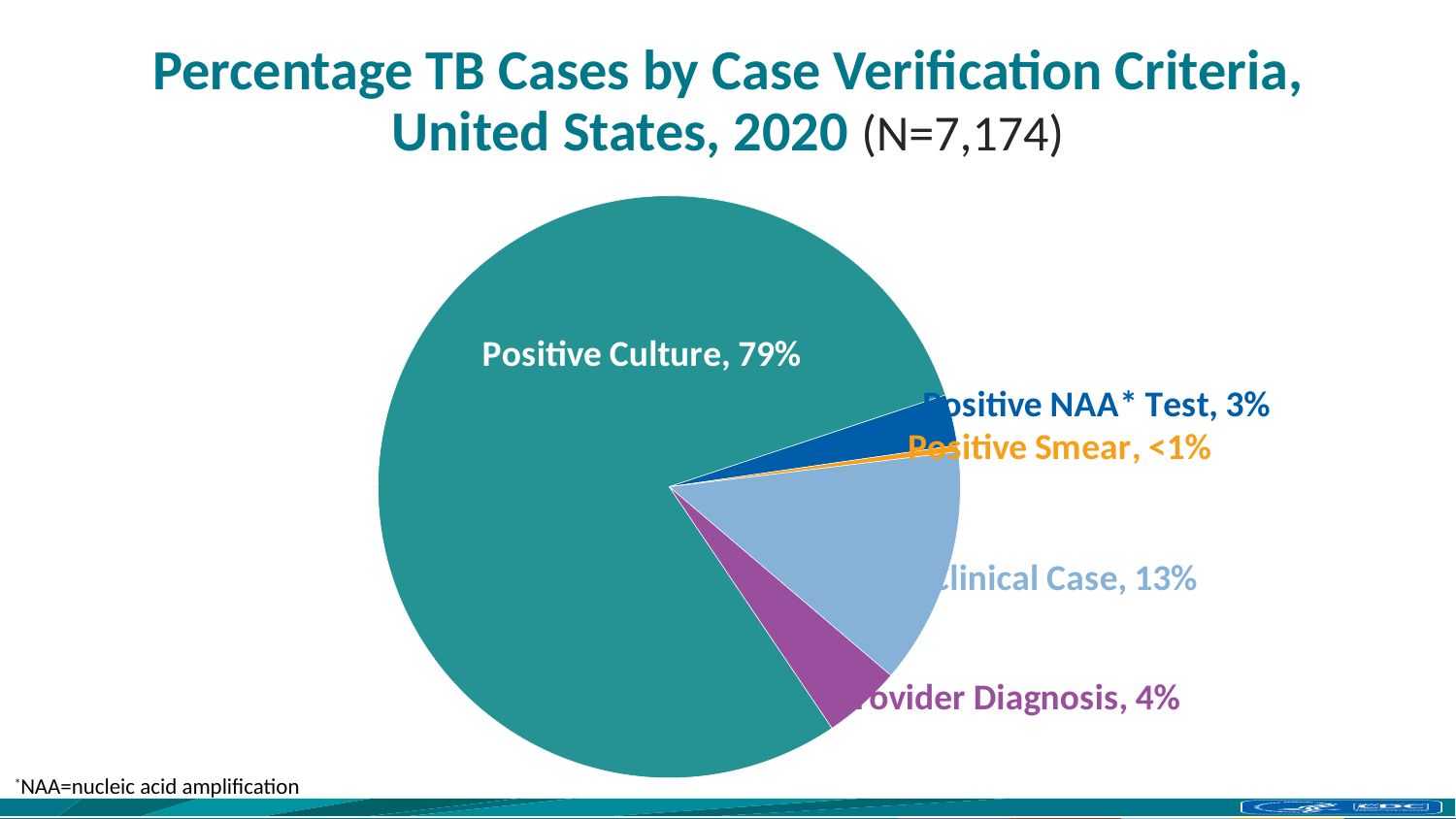
What is the total number of TB cases (N) stated in the chart title? 7,174 What kind of chart is shown on the slide? pie chart What percentage of TB cases were verified as Clinical Case? 13% What percentage of TB cases were verified by Positive NAA Test? 3% What is the difference in percentage points between Positive Culture and Clinical Case? 66 Which case verification criterion accounts for the smallest share of TB cases? Positive Smear What percentage of TB cases were verified by Positive Culture? 79% What percentage of TB cases were verified by Positive Smear? <1% Which case verification criterion accounts for the largest share of TB cases? Positive Culture How many case verification categories are shown in the pie chart? 5 Which is larger, the share for Clinical Case or the share for Provider Diagnosis? Clinical Case What percentage of TB cases were verified by Provider Diagnosis? 4%